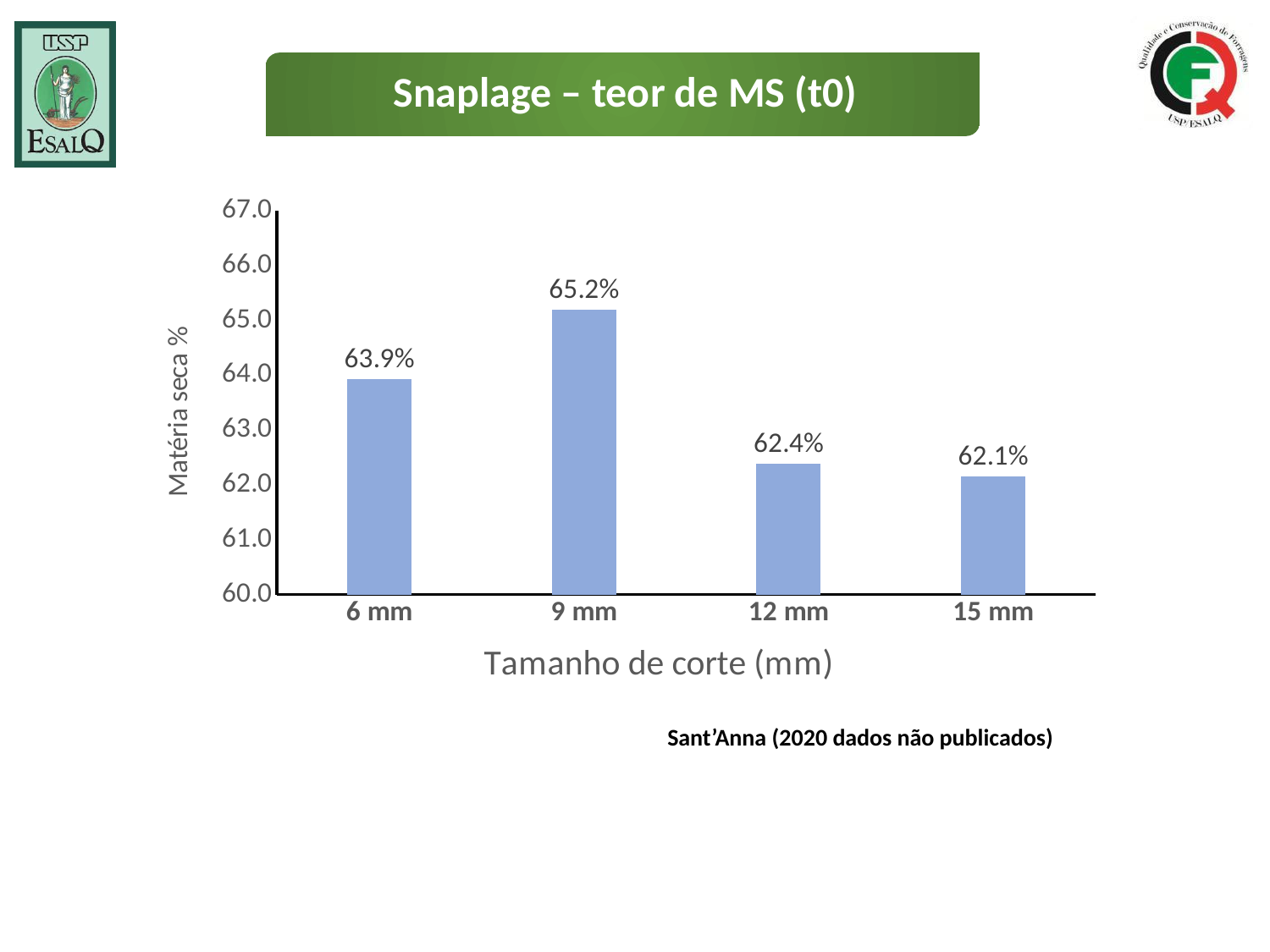
What is the title of the slide's chart? Snaplage – teor de MS (t0) What is the dry matter (Matéria seca %) value for 6 mm? 63.9% Which cut size has the highest dry matter value? 9 mm Is the value for 9 mm greater or less than 65.0? greater How many cut sizes are shown on the x axis? 4 What is the dry matter value for 9 mm? 65.2% What kind of chart is shown on the slide? Bar chart What is the difference between the dry matter values for 9 mm and 6 mm? 1.3% What is the dry matter value for 15 mm? 62.1% What is the dry matter value for 12 mm? 62.4% Which has a larger dry matter value, 6 mm or 12 mm? 6 mm Which cut size has the lowest dry matter value? 15 mm